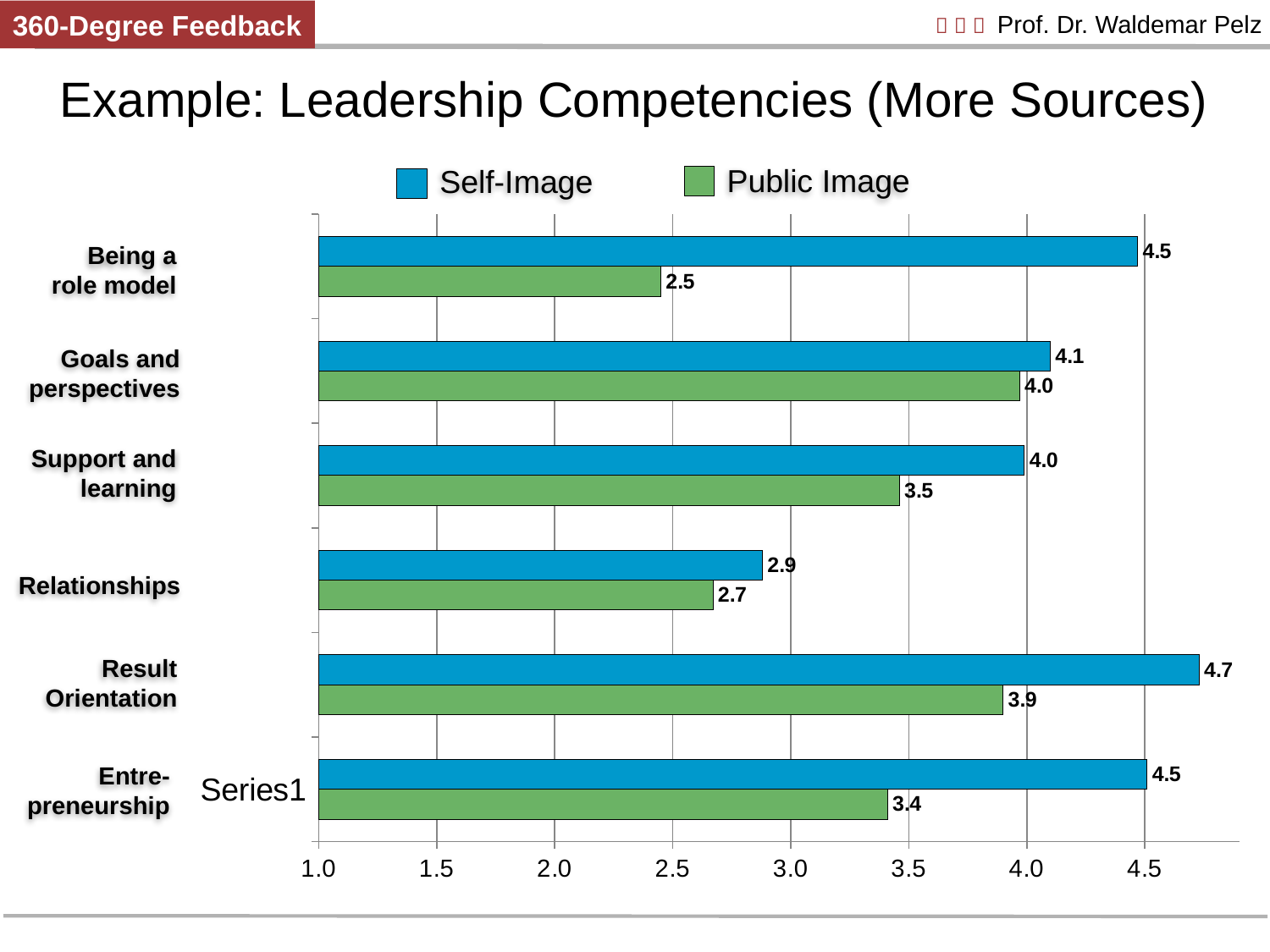
Which is larger for Entrepreneurship, the Self-Image value or the Public Image value? Self-Image Which category has the lowest Self-Image value? Relationships Which category has the highest Self-Image value? Result Orientation What is the Self-Image value for Relationships? 2.9 What is the Public Image value for Result Orientation? 3.9 Which category has the lowest Public Image value? Being a role model What is the difference between the Self-Image and Public Image values for Result Orientation? 0.8 How many series does the legend list? 2 What is the Self-Image value for Being a role model? 4.5 What is the Public Image value for Support and learning? 3.5 How many categories are shown on the chart? 6 What is the difference between the Self-Image and Public Image values for Being a role model? 2.0